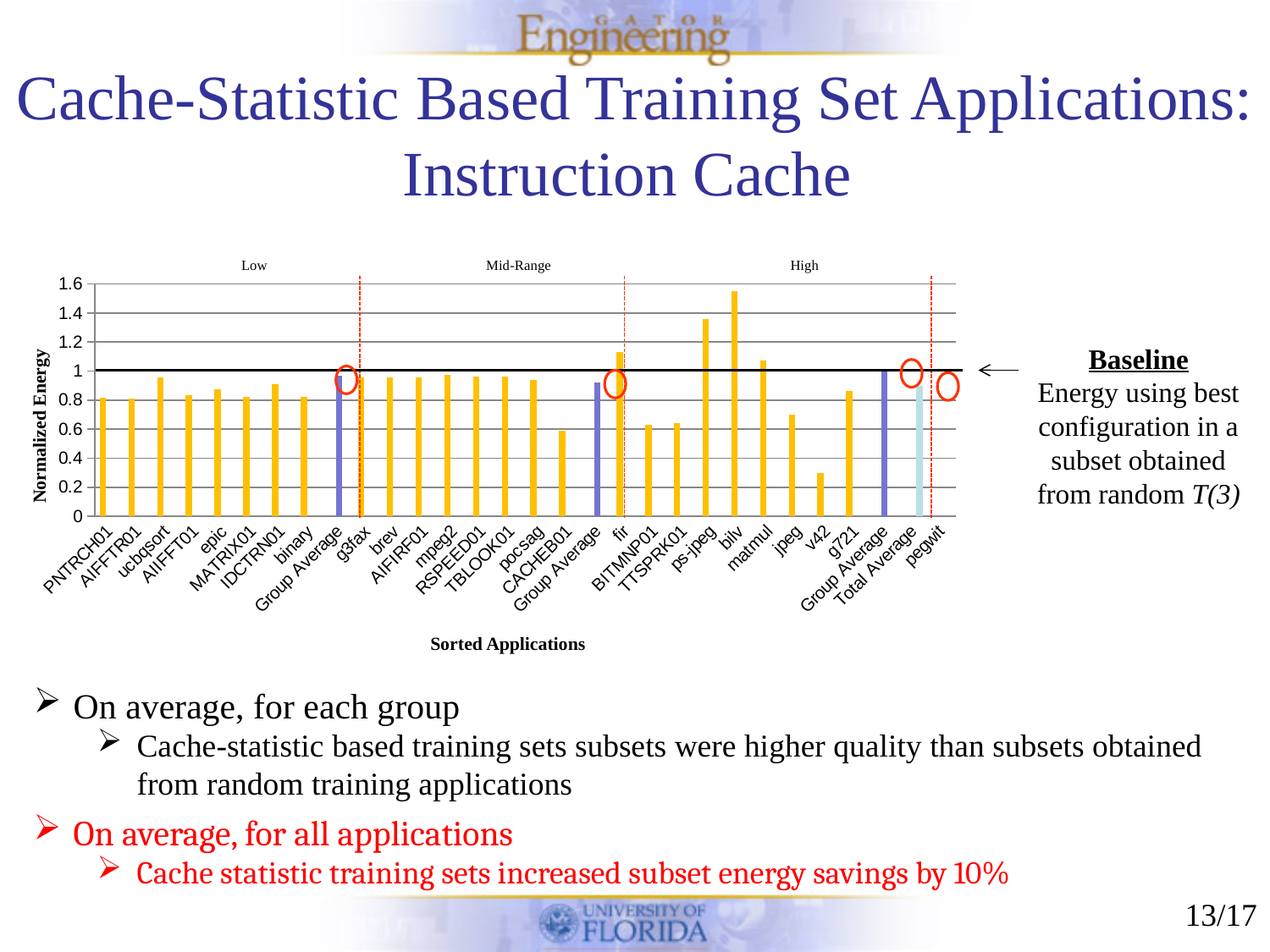
What are the three group labels shown above the chart? Low, Mid-Range, High Which has the larger normalized energy, jpeg or v42? jpeg Which has the larger normalized energy, bilv or ps-jpeg? bilv What kind of chart is shown on the slide? bar chart Is the value for v42 greater or less than 0.4? less Which application has the highest normalized energy in the chart? bilv Is the value for ps-jpeg greater or less than 1.2? greater What is the title of the vertical axis of the chart? Normalized Energy Is the value for bilv greater or less than 1.4? greater Which application has the lowest normalized energy in the chart? v42